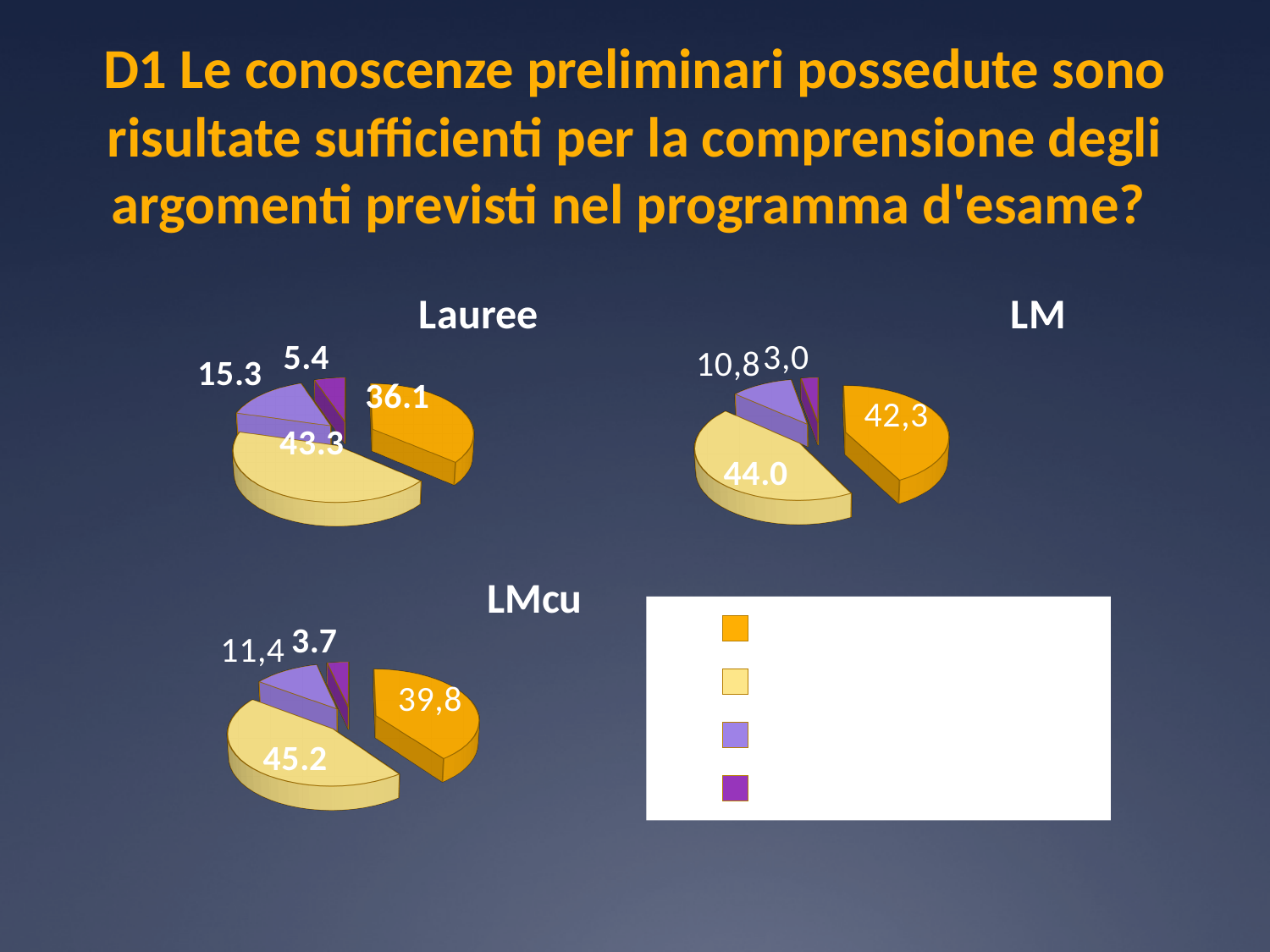
In the Lauree pie chart, what value is shown for the orange slice? 36.1 What kind of chart is the LMcu chart? pie chart How many slices does the Lauree pie chart have? 4 In the LMcu pie chart, what value is shown for the lavender slice? 11,4 In the LMcu pie chart, which slice has the largest value? the light yellow slice (45.2) In the LM pie chart, which is larger, the lavender slice or the dark purple slice? the lavender slice In the LM pie chart, which slice has the smallest value? the dark purple slice (3,0) How many pie charts are shown on the slide? 3 In the Lauree pie chart, what is the difference between the light yellow slice and the orange slice? 7.2 In the Lauree pie chart, what value is shown for the light yellow slice? 43.3 In the LM pie chart, what value is shown for the orange slice? 42,3 In the LMcu pie chart, what value is shown for the dark purple slice? 3.7